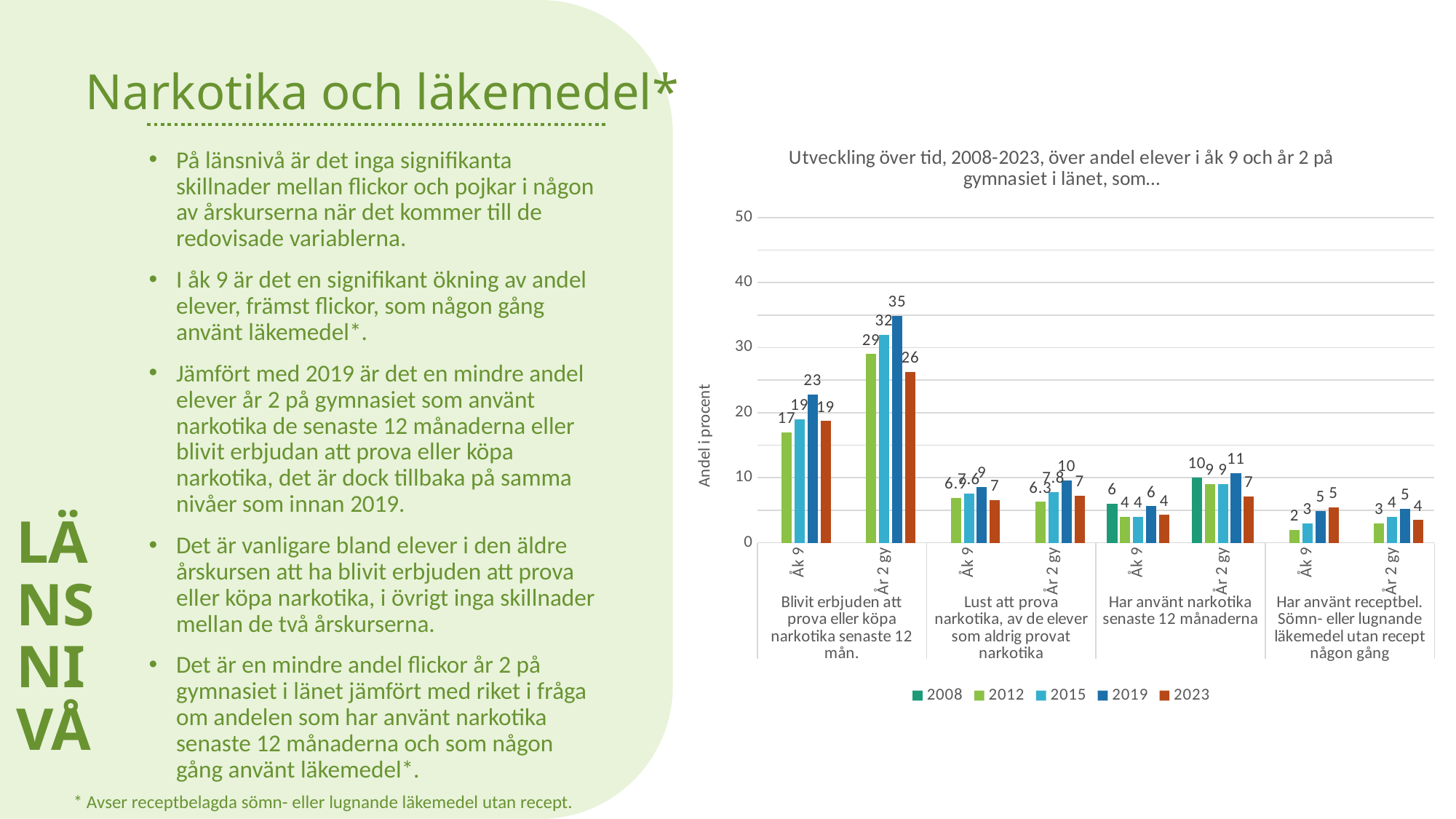
What is the 2023 value for År 2 gy in the group 'Har använt narkotika senaste 12 månaderna'? 7 What is the 2008 value for År 2 gy in the group 'Har använt narkotika senaste 12 månaderna'? 10 What kind of chart is shown on the slide? Bar chart What is the 2023 value for Åk 9 in the group 'Blivit erbjuden att prova eller köpa narkotika senaste 12 mån.'? 19 What is the 2012 value for Åk 9 in the group 'Har använt receptbel. Sömn- eller lugnande läkemedel utan recept någon gång'? 2 What is the 2019 value for År 2 gy in the group 'Blivit erbjuden att prova eller köpa narkotika senaste 12 mån.'? 35 What is the label on the vertical axis of the chart? Andel i procent How many series does the legend list? 5 For År 2 gy in the group 'Blivit erbjuden att prova eller köpa narkotika senaste 12 mån.', which year has the highest value? 2019 Is the 2012 value for År 2 gy in the group 'Blivit erbjuden att prova eller köpa narkotika senaste 12 mån.' greater or less than 20? greater What is the difference between the 2019 and 2023 values for År 2 gy in the group 'Blivit erbjuden att prova eller köpa narkotika senaste 12 mån.'? 9 In 2012, which is larger for 'Blivit erbjuden att prova eller köpa narkotika senaste 12 mån.': Åk 9 or År 2 gy? År 2 gy